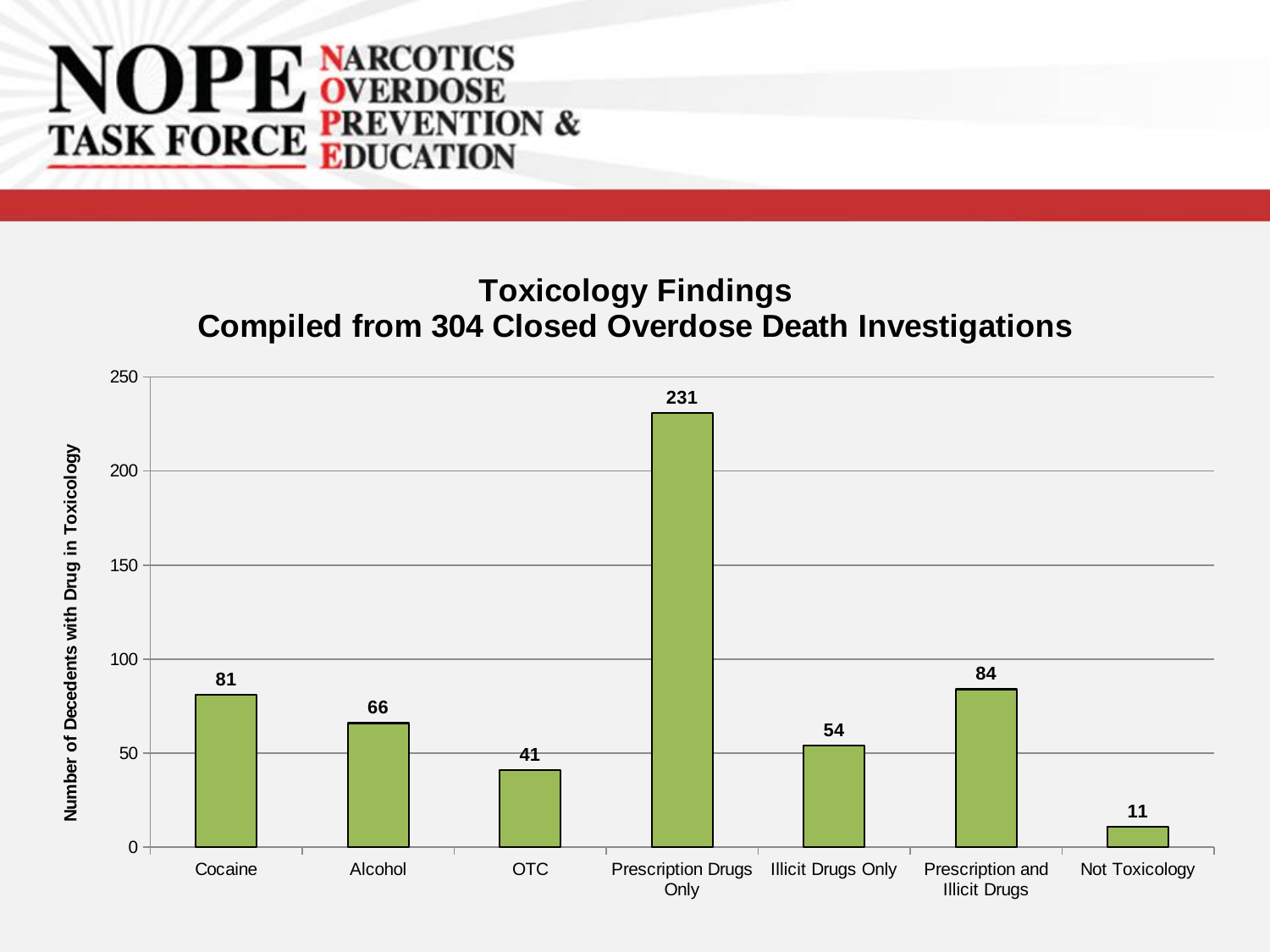
What is the value for Cocaine? 81 Which is larger, the value for Cocaine or the value for Illicit Drugs Only? Cocaine What is the label of the vertical axis? Number of Decedents with Drug in Toxicology Which category has the lowest value? Not Toxicology How many categories are shown on the x axis? 7 What is the value for Not Toxicology? 11 Is the value for Prescription Drugs Only greater or less than 200? greater What is the value for Prescription Drugs Only? 231 Which category has the highest value? Prescription Drugs Only What is the difference between the values for Prescription Drugs Only and Prescription and Illicit Drugs? 147 What kind of chart is shown on the slide? bar chart What is the difference between the values for Alcohol and OTC? 25